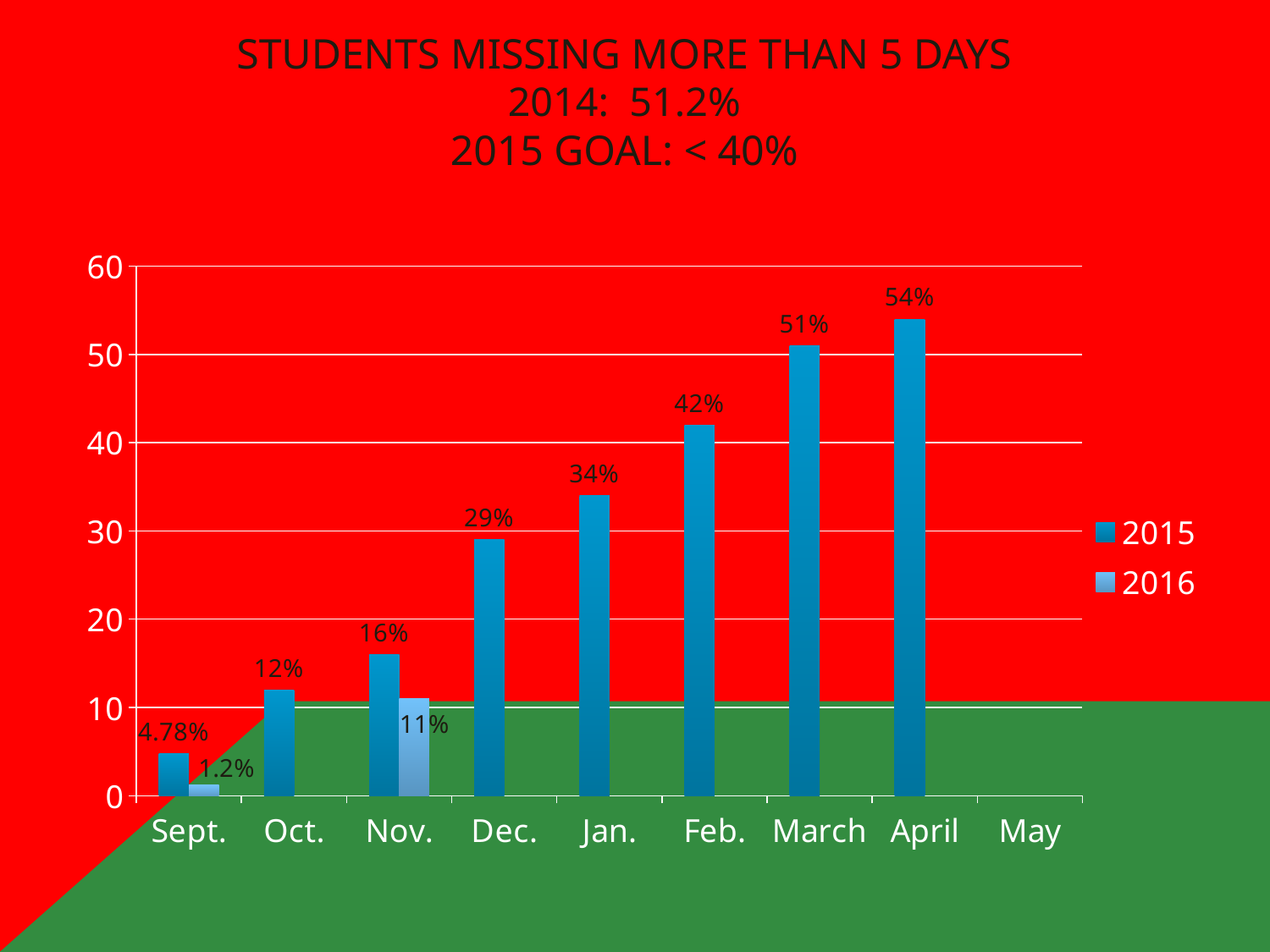
Which month has the highest 2015 value? April How many series does the legend list? 2 What kind of chart is shown? bar chart What is the 2015 value for Sept.? 4.78% What is the difference between the 2015 values for April and March? 3% What is the 2015 value for April? 54% Do the 2015 values rise or fall from Sept. to April? rise What is the 2016 value for Nov.? 11% Which month has the lowest 2015 value? Sept. How many months are shown on the x axis? 9 Is the 2015 value for Feb. greater or less than 40? greater Which is larger, the 2015 value for Nov. or the 2016 value for Nov.? 2015